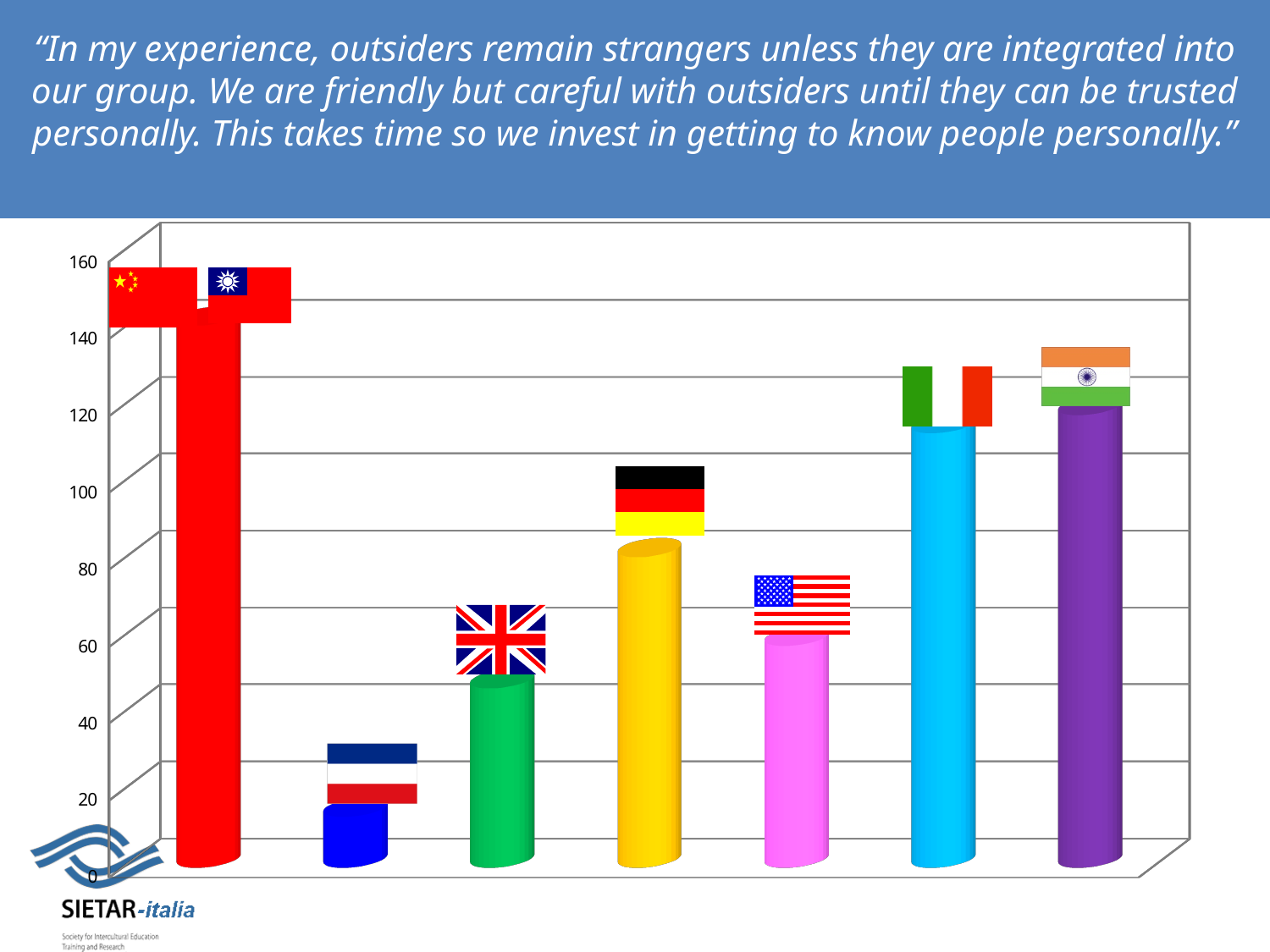
Is the value of the yellow (fourth) bar greater or less than 100? less Is the value of the green (third) bar greater or less than 60? less Which is larger, the yellow (fourth) bar or the pink (fifth) bar? the yellow bar What is the highest value shown on the vertical axis? 160 Is the value of the red (leftmost) bar greater or less than 120? greater How many bars does the chart contain? 7 What is placed on top of each bar in the chart? a national flag Which bar is the shortest in the chart? the blue bar (second from left) Which bar is the tallest in the chart? the red bar (leftmost) What kind of chart is shown on the slide? bar chart